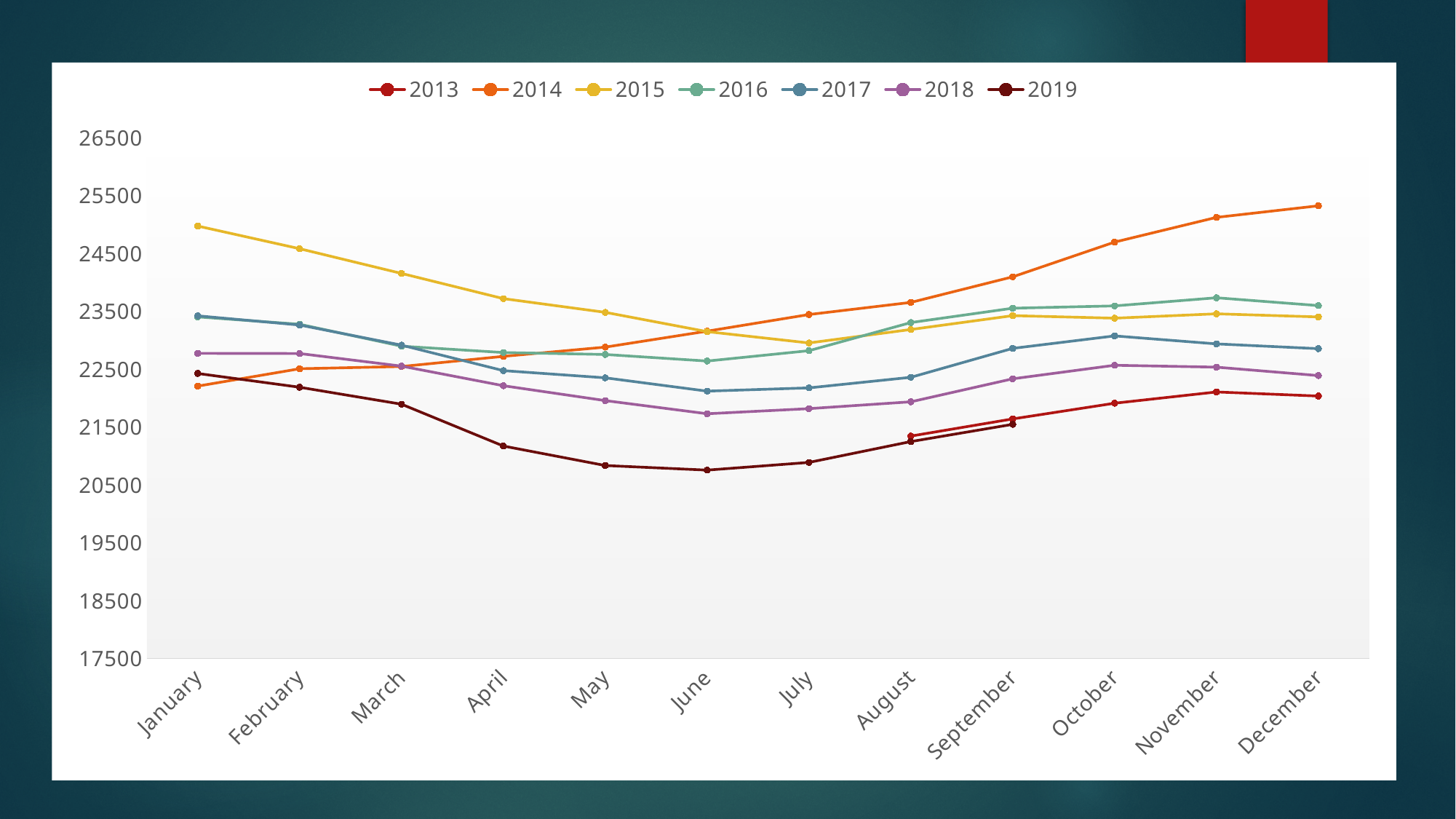
Which series has the highest value in December? 2014 How many months are shown along the x axis? 12 Which series has the highest value in January? 2015 Which series is drawn in orange? 2014 In December, which is larger: the value for 2014 or the value for 2015? 2014 Is the value for 2015 in January greater or less than 24500? greater What kind of chart is shown on the slide? line chart Does the 2014 series rise or fall from January to December? rise Is the value for 2019 in June greater or less than 21500? less Which series has the lowest value in June? 2019 Is the value for 2018 in June greater or less than 22500? less How many series does the legend list? 7